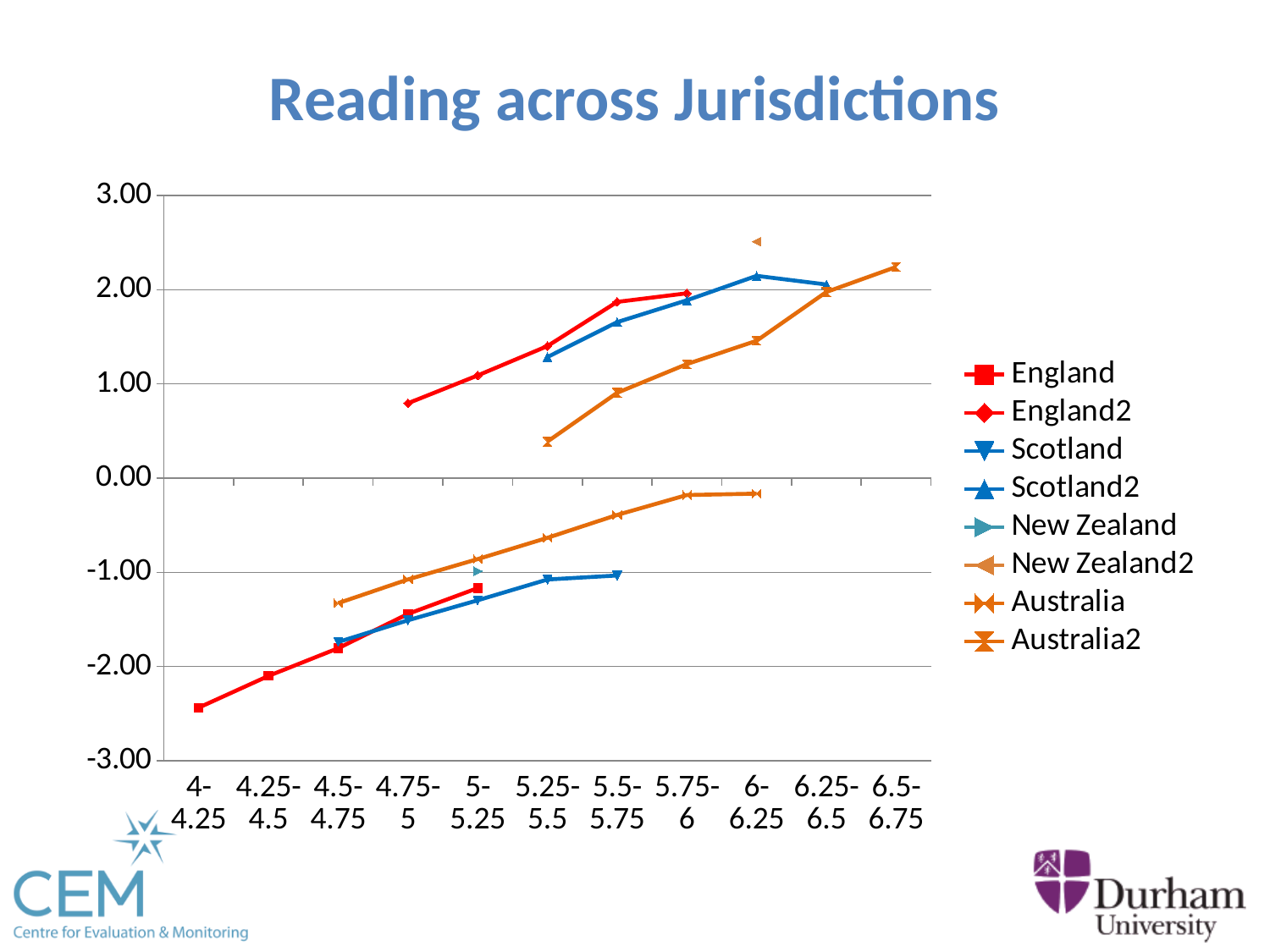
What is the title of the chart? Reading across Jurisdictions Is the value for Australia at 6-6.25 greater or less than 0.00? less Is the value for England at 4-4.25 greater or less than -2.00? less At 6-6.25, which is larger, Scotland2 or Australia2? Scotland2 How many categories are shown on the x axis? 11 At 5.5-5.75, which is larger, England2 or Scotland2? England2 What kind of chart is shown on the slide? line chart Is the value for England2 at 4.75-5 greater or less than 1.00? less How many series does the legend list? 8 Do the values for England rise or fall as you move along the x axis? rise